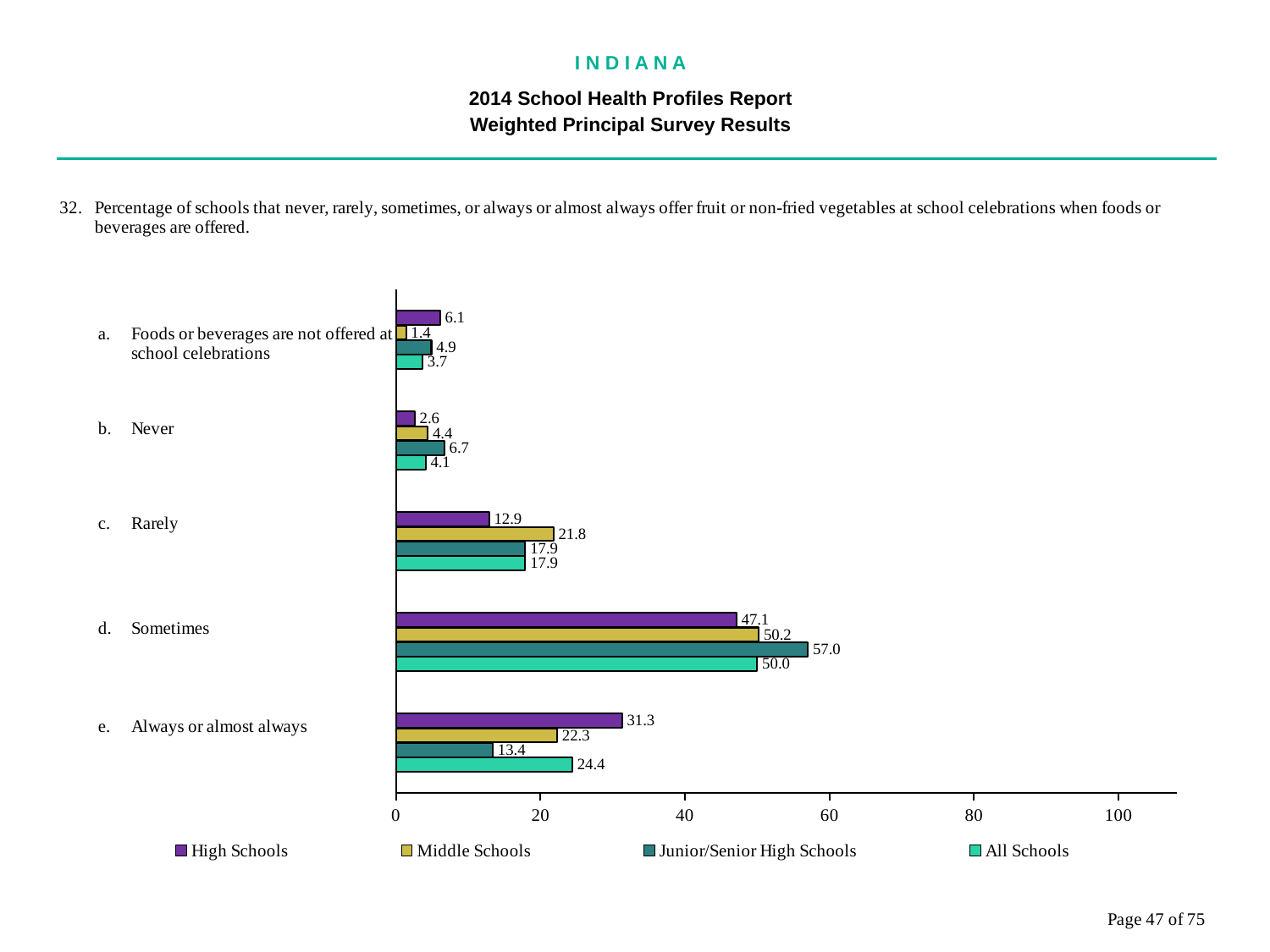
What is the value for Middle Schools in the 'Rarely' category? 21.8 Which series is shown in yellow in the legend? Middle Schools How many categories are shown on the chart? 5 Which is larger in the 'Always or almost always' category: High Schools or Middle Schools? High Schools Which series has the lowest value in the 'Foods or beverages are not offered at school celebrations' category? Middle Schools What is the value for High Schools in the 'Sometimes' category? 47.1 Is the value for Junior/Senior High Schools in the 'Sometimes' category greater or less than 40? greater What is the difference between the Junior/Senior High Schools and High Schools values in the 'Sometimes' category? 9.9 Which category has the highest value for All Schools? Sometimes What is the value for Junior/Senior High Schools in the 'Always or almost always' category? 13.4 How many series does the legend list? 4 What kind of chart is shown on the slide? Bar chart